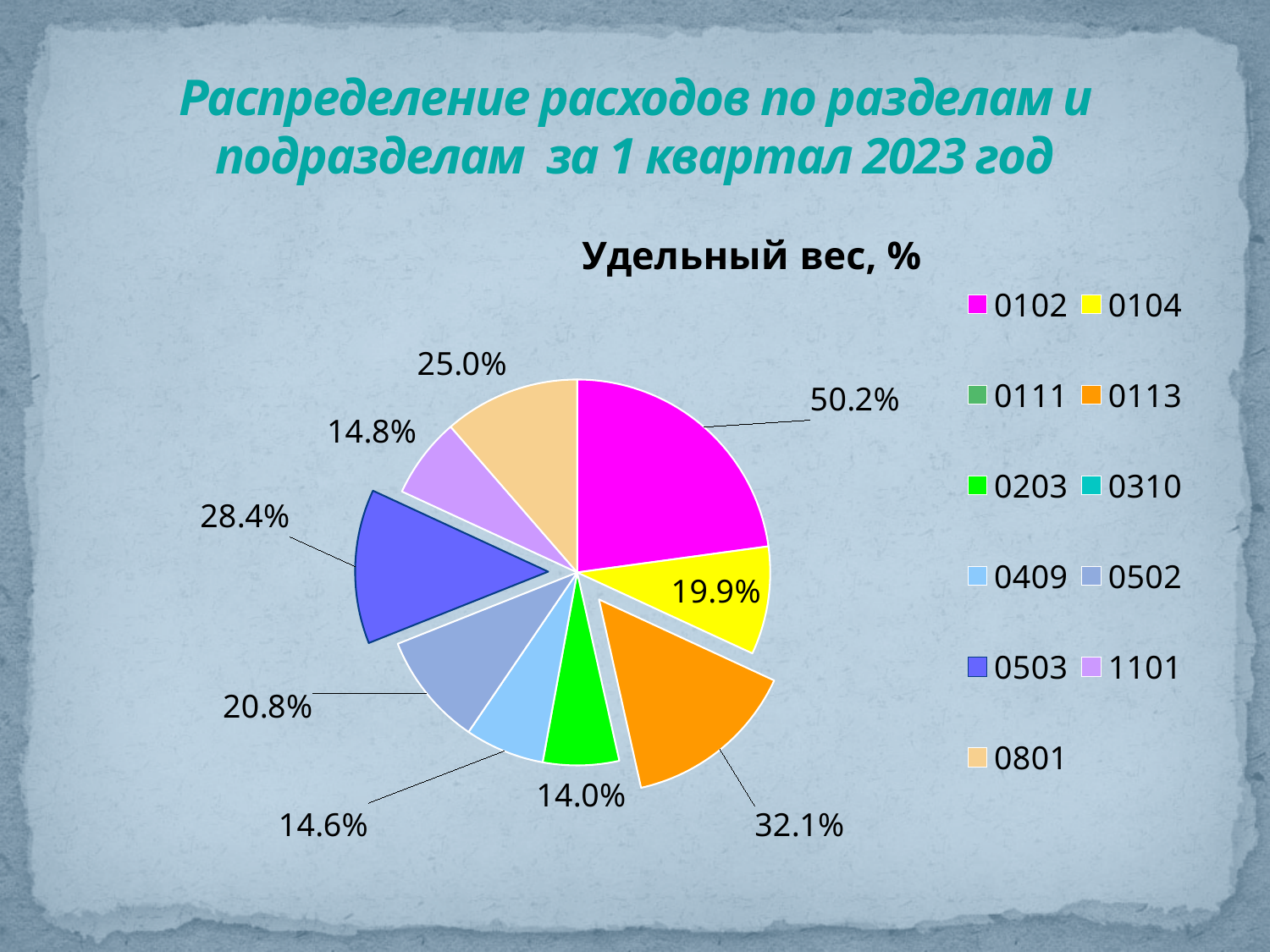
What is the value shown for category 0113? 32.1% What is the value shown for category 0503? 28.4% Which labelled slice has the smallest value in the pie chart? 0203 What type of chart is shown on the slide? pie chart What is the value shown for category 0104? 19.9% What is the title of the chart? Удельный вес, % Which category has the largest slice in the pie chart? 0102 What is the value shown for category 0102? 50.2% Which is larger, the value for 0502 or the value for 0409? 0502 What is the value shown for category 0801? 25.0% What is the difference between the values for 0102 and 0113? 18.1% How many entries does the chart legend list? 11